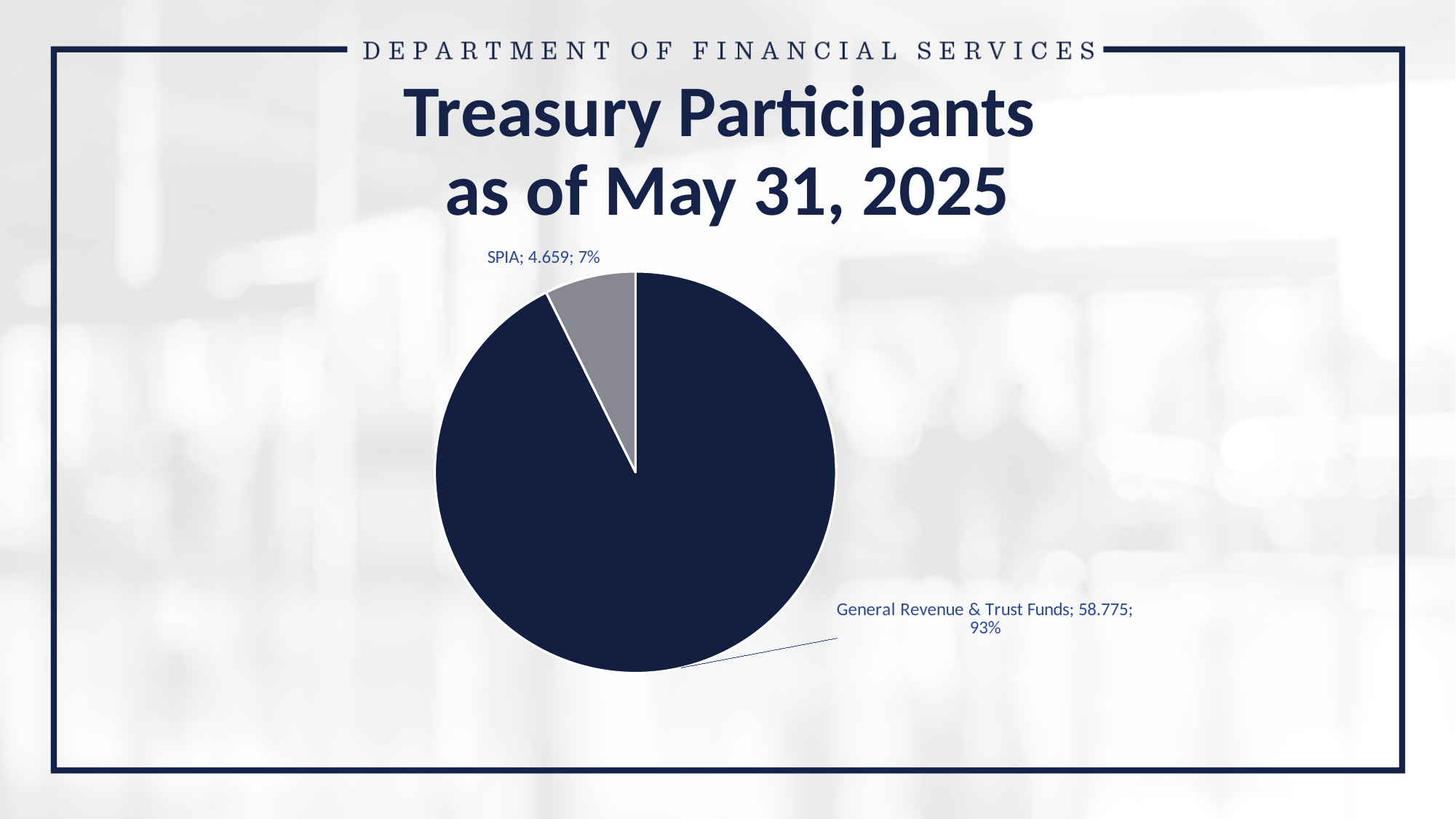
What share of the pie does General Revenue & Trust Funds represent? 93% Which slice is the smallest? SPIA Which is larger, SPIA or General Revenue & Trust Funds? General Revenue & Trust Funds What is the value for SPIA? 4.659 What share of the pie does SPIA represent? 7% What is the difference between the values for General Revenue & Trust Funds and SPIA? 54.116 What is the value for General Revenue & Trust Funds? 58.775 What colour is the SPIA slice? grey What kind of chart is shown on the slide? pie chart What is the title of the chart? Treasury Participants as of May 31, 2025 Which slice is the largest? General Revenue & Trust Funds How many slices does the pie chart have? 2